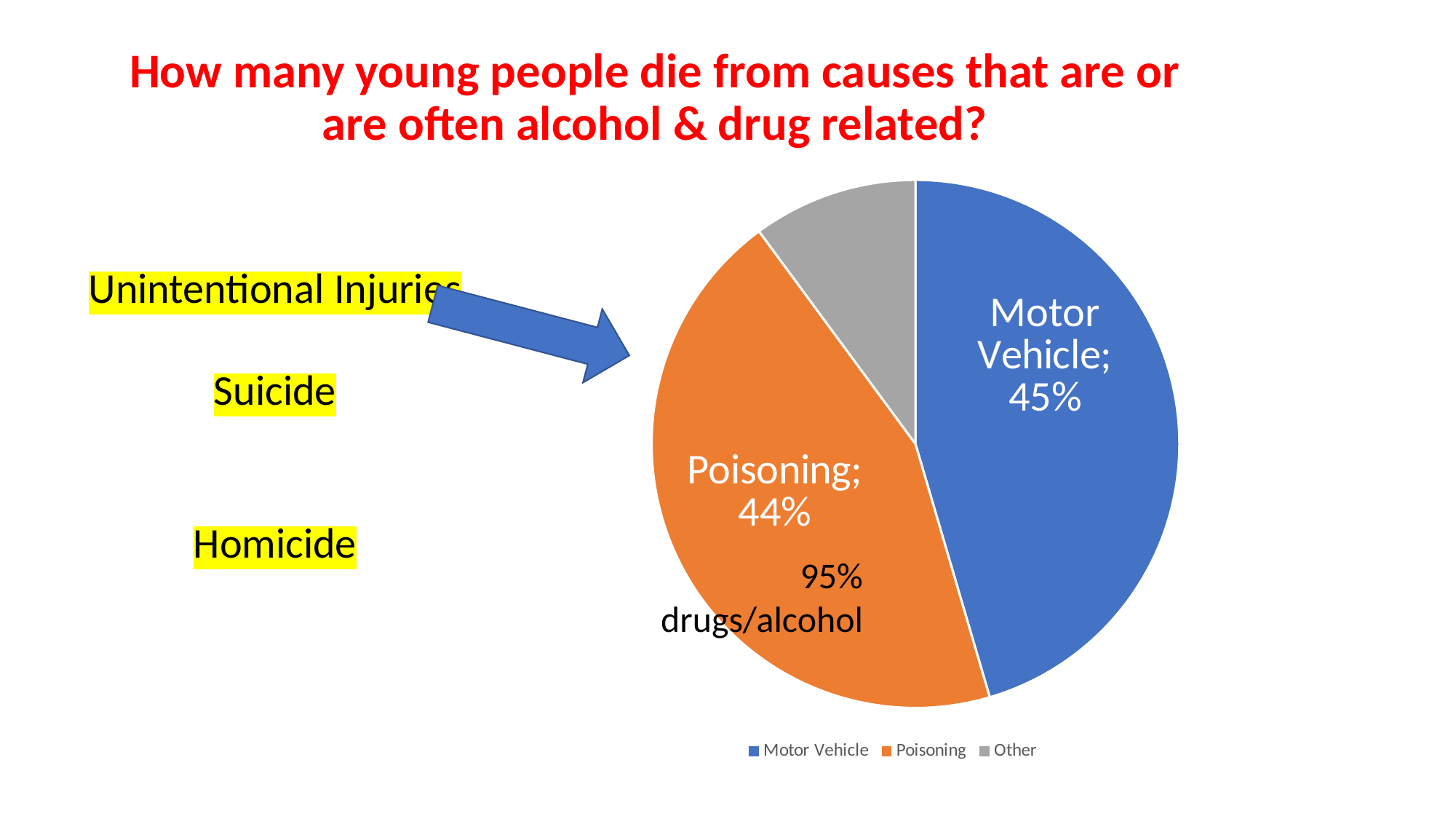
Which is larger in the pie chart, Motor Vehicle or Poisoning? Motor Vehicle By how many percentage points does the Motor Vehicle slice exceed the Poisoning slice? 1 percentage point What kind of chart is shown on the slide? Pie chart How many slices does the pie chart have? 3 Which slice of the pie chart is the smallest? Other What percentage of the pie chart is labelled for Poisoning? 44% What percentage of the pie chart is labelled for Motor Vehicle? 45% What annotation is written on the Poisoning slice below its percentage label? 95% drugs/alcohol Which slice of the pie chart is the largest? Motor Vehicle What colour is the Poisoning slice in the pie chart? Orange How many entries does the legend of the pie chart list? 3